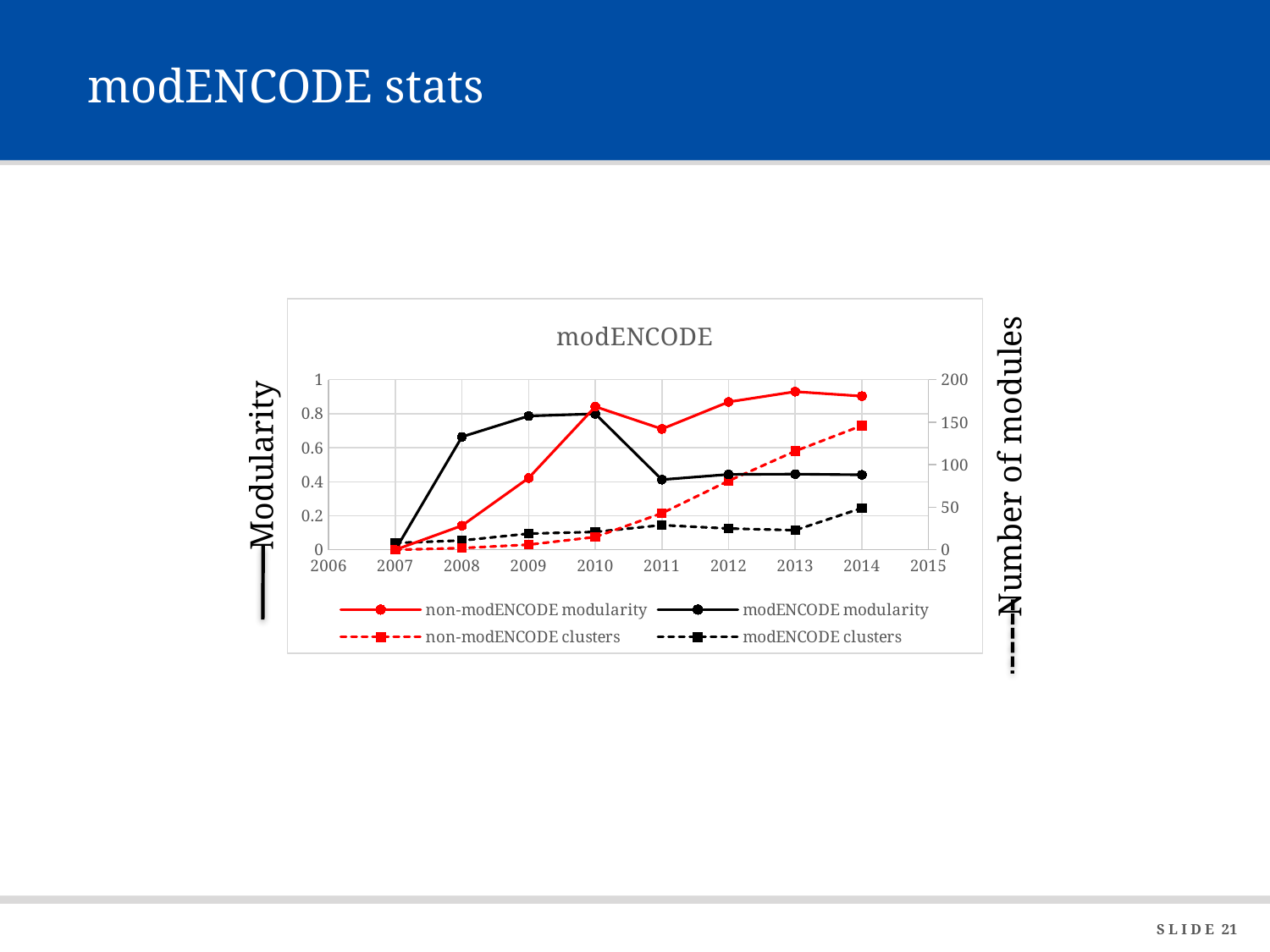
How many series does the legend list? 4 What is the label of the right-hand vertical axis? Number of modules Is the non-modENCODE modularity value for 2008 greater or less than 0.2? less Is the non-modENCODE modularity value for 2013 greater or less than 0.8? greater Is the non-modENCODE clusters value for 2013 greater or less than 100? greater In which year is the non-modENCODE clusters series at its highest? 2014 What is the title of the chart? modENCODE Does the non-modENCODE clusters series generally rise or fall from 2007 to 2014? rise What kind of chart is shown on the slide? Line chart In 2011, which is larger: non-modENCODE modularity or modENCODE modularity? non-modENCODE modularity How many years have data points plotted for the non-modENCODE modularity series? 8